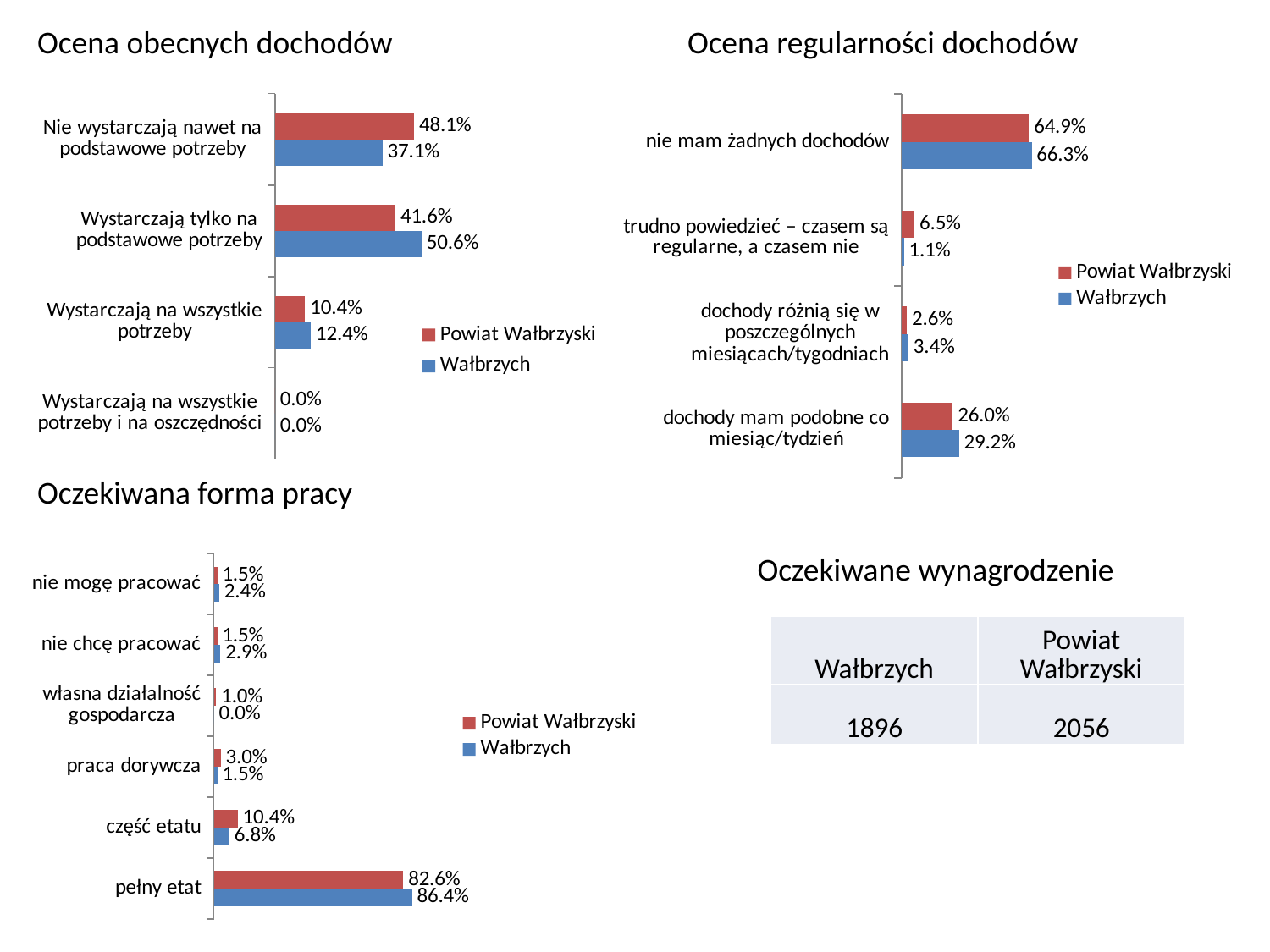
In the 'Oczekiwana forma pracy' chart, what is the value for Wałbrzych for 'pełny etat'? 86.4% In the 'Oczekiwana forma pracy' chart, which category has the lowest value for Wałbrzych? własna działalność gospodarcza In the 'Ocena regularności dochodów' chart, which is larger for 'trudno powiedzieć – czasem są regularne, a czasem nie': Powiat Wałbrzyski or Wałbrzych? Powiat Wałbrzyski In the 'Ocena regularności dochodów' chart, what is the value for Powiat Wałbrzyski for 'dochody mam podobne co miesiąc/tydzień'? 26.0% In the 'Ocena regularności dochodów' chart, which category has the highest value for Wałbrzych? nie mam żadnych dochodów In the 'Oczekiwana forma pracy' chart, what is the difference between the Powiat Wałbrzyski and Wałbrzych values for 'część etatu'? 3.6% In the 'Ocena obecnych dochodów' chart, what is the value for Powiat Wałbrzyski for 'Nie wystarczają nawet na podstawowe potrzeby'? 48.1% What type of chart is 'Oczekiwana forma pracy'? bar chart In the 'Ocena obecnych dochodów' chart, what is the difference between the Wałbrzych and Powiat Wałbrzyski values for 'Wystarczają na wszystkie potrzeby'? 2.0% In the 'Ocena regularności dochodów' chart, how many series does the legend list? 2 In the 'Ocena obecnych dochodów' chart, how many categories are shown? 4 In the 'Ocena obecnych dochodów' chart, what is the value for Wałbrzych for 'Wystarczają tylko na podstawowe potrzeby'? 50.6%